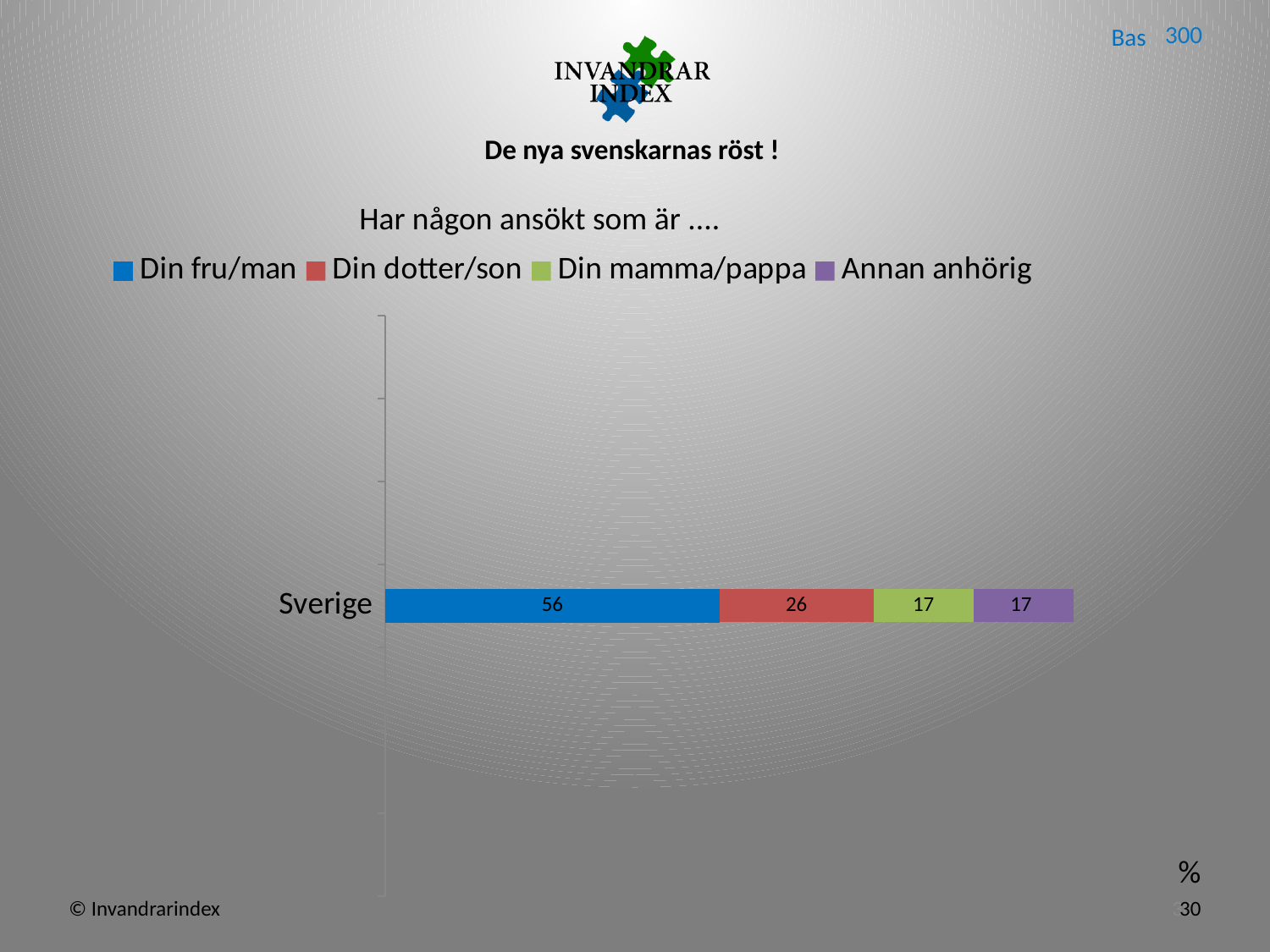
What is the difference between the values for Din fru/man and Din dotter/son for Sverige? 30 What kind of chart is shown on the slide? Stacked bar chart What is the title of the chart? Har någon ansökt som är .... What is the value for Annan anhörig for Sverige? 17 What is the total of the stacked bar for Sverige? 116 Which is larger for Sverige, Din dotter/son or Din mamma/pappa? Din dotter/son How many categories are shown on the chart? 1 What is the value for Din fru/man for Sverige? 56 Which series has the highest value for Sverige? Din fru/man What is the value for Din dotter/son for Sverige? 26 What is the value for Din mamma/pappa for Sverige? 17 How many series does the legend list? 4